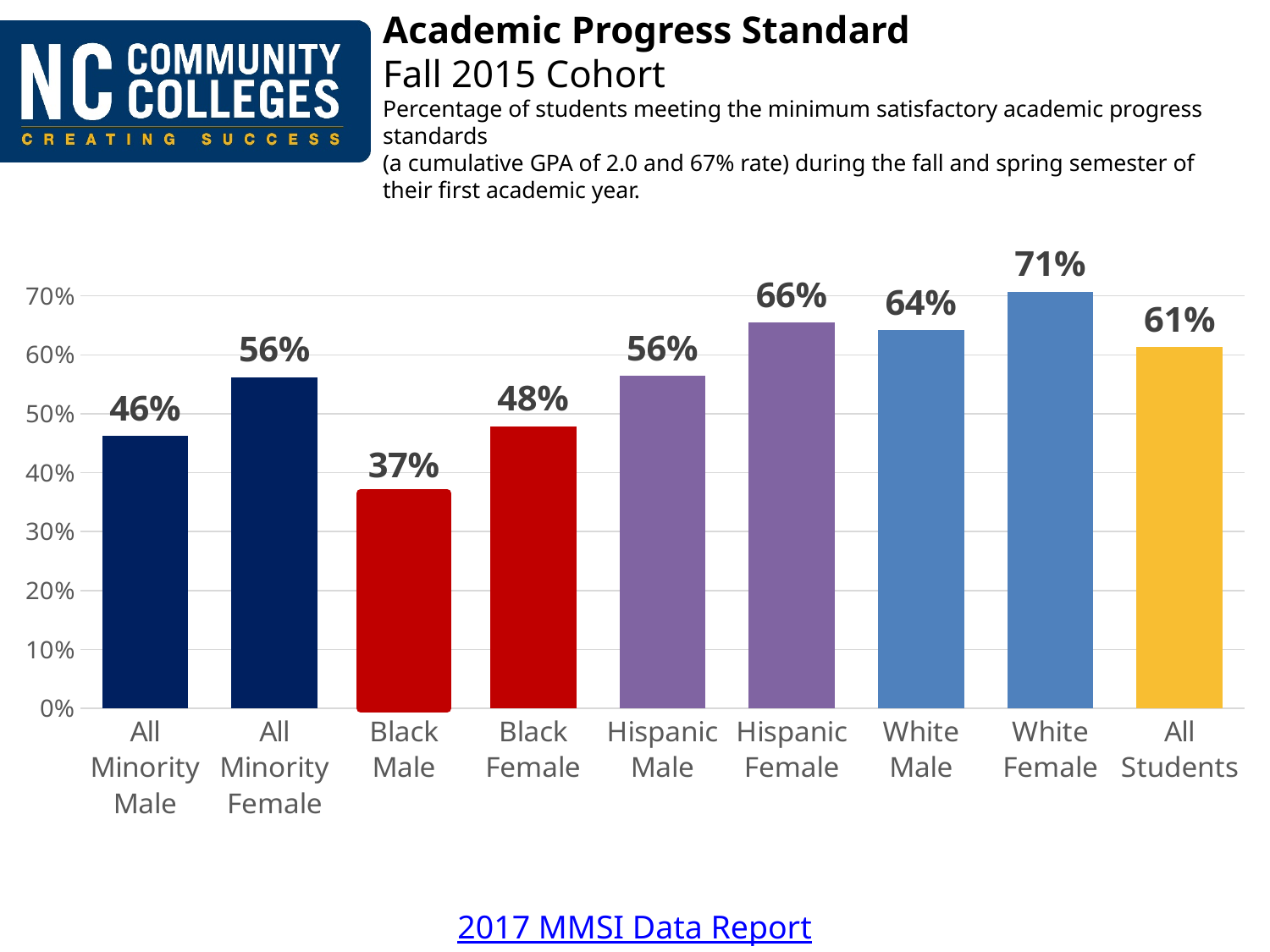
What percentage is shown for Hispanic Female students? 66% What is the difference between the White Female and Black Male percentages? 34% What percentage of Black Male students met the academic progress standard? 37% What is the title of the chart? Academic Progress Standard What is the difference between the All Minority Female and All Minority Male percentages? 10% Which is larger, the value for White Male or the value for Hispanic Female? Hispanic Female Is the value for Black Female greater or less than 50%? less Which category has the highest percentage? White Female What is the value shown for All Students? 61% What kind of chart is shown on the slide? Bar chart How many categories are shown on the x axis? 9 Which category has the lowest percentage? Black Male